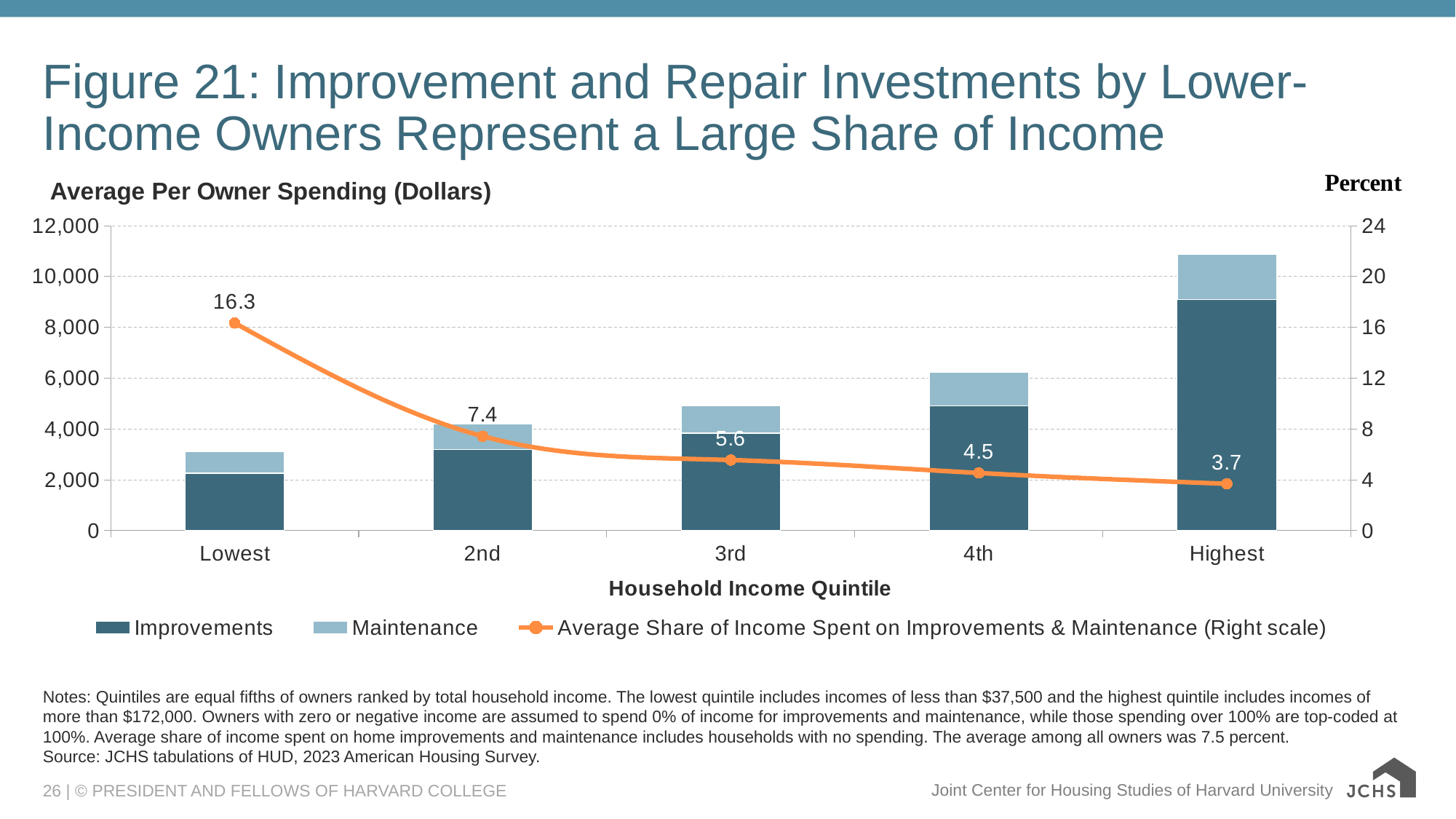
Is the total average per owner spending for the Highest quintile greater or less than 10,000? greater Does the average share of income spent on improvements and maintenance rise or fall from the Lowest to the Highest quintile? fall Is the total average per owner spending for the Lowest quintile greater or less than 4,000? less How many series does the legend list? 3 Which quintile has a larger average share of income spent on improvements and maintenance, 3rd or 4th? 3rd Which income quintile has the lowest average share of income spent on improvements and maintenance? Highest How many household income quintiles are shown on the x axis? 5 What is the average share of income spent on improvements and maintenance for the Lowest income quintile? 16.3 What is the average share of income spent on improvements and maintenance for the Highest income quintile? 3.7 Which income quintile has the highest average share of income spent on improvements and maintenance? Lowest What is the average share of income spent on improvements and maintenance for the 2nd income quintile? 7.4 What is the difference in average share of income spent between the Lowest and 2nd quintiles? 8.9